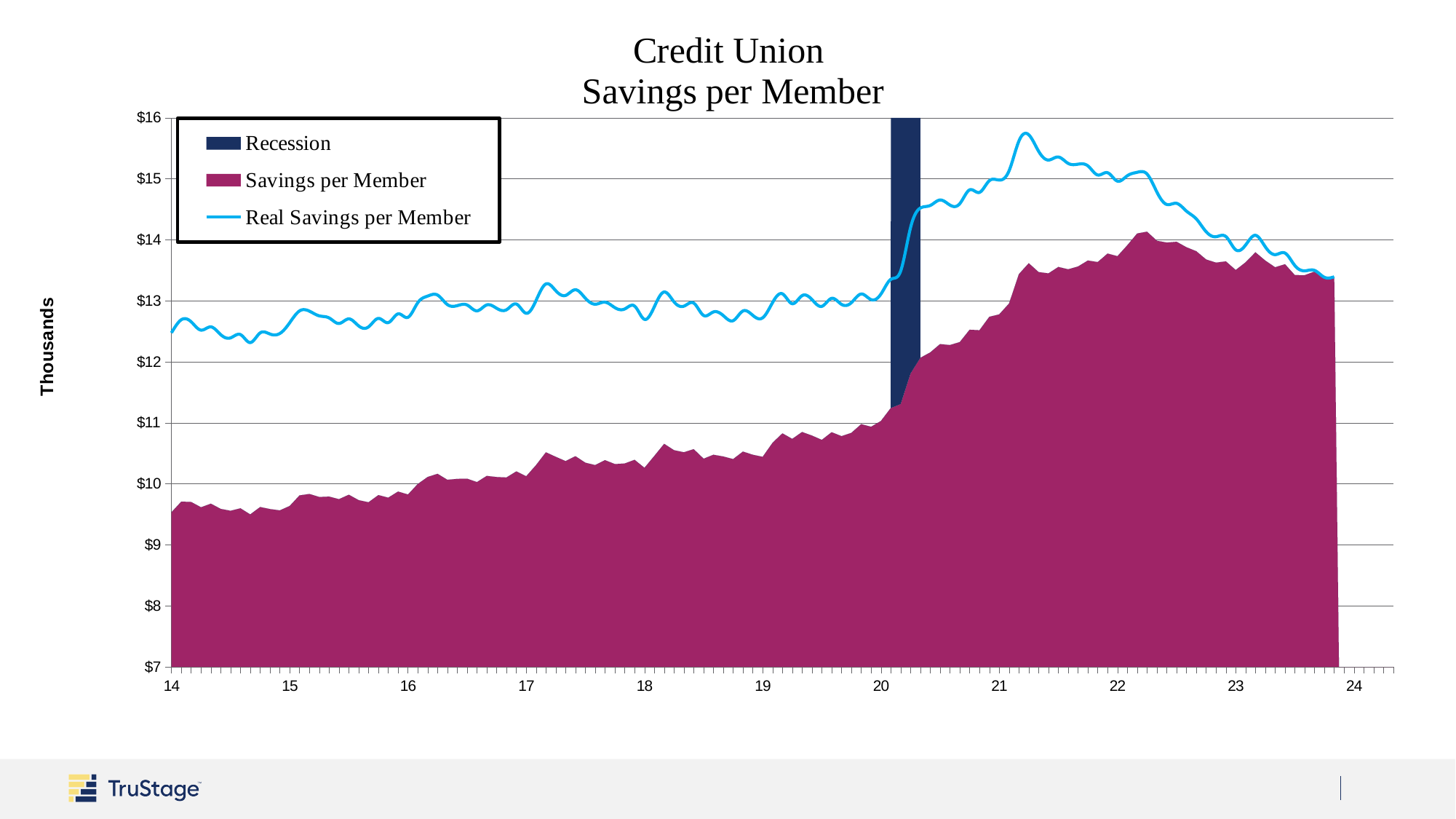
Is the peak value of Real Savings per Member (around 21) greater or less than $15? greater What is the label on the vertical axis? Thousands What is the title of the chart? Credit Union Savings per Member Is the value for Real Savings per Member at 14 greater or less than $12? greater Is the value for Savings per Member at 14 greater or less than $10? less What kind of chart is shown on the slide? Area chart with a line series At 14, which is larger: Savings per Member or Real Savings per Member? Real Savings per Member How many series does the legend list? 3 Does Real Savings per Member rise or fall from 21 to 24? fall Does Savings per Member rise or fall from 14 to 22? rise